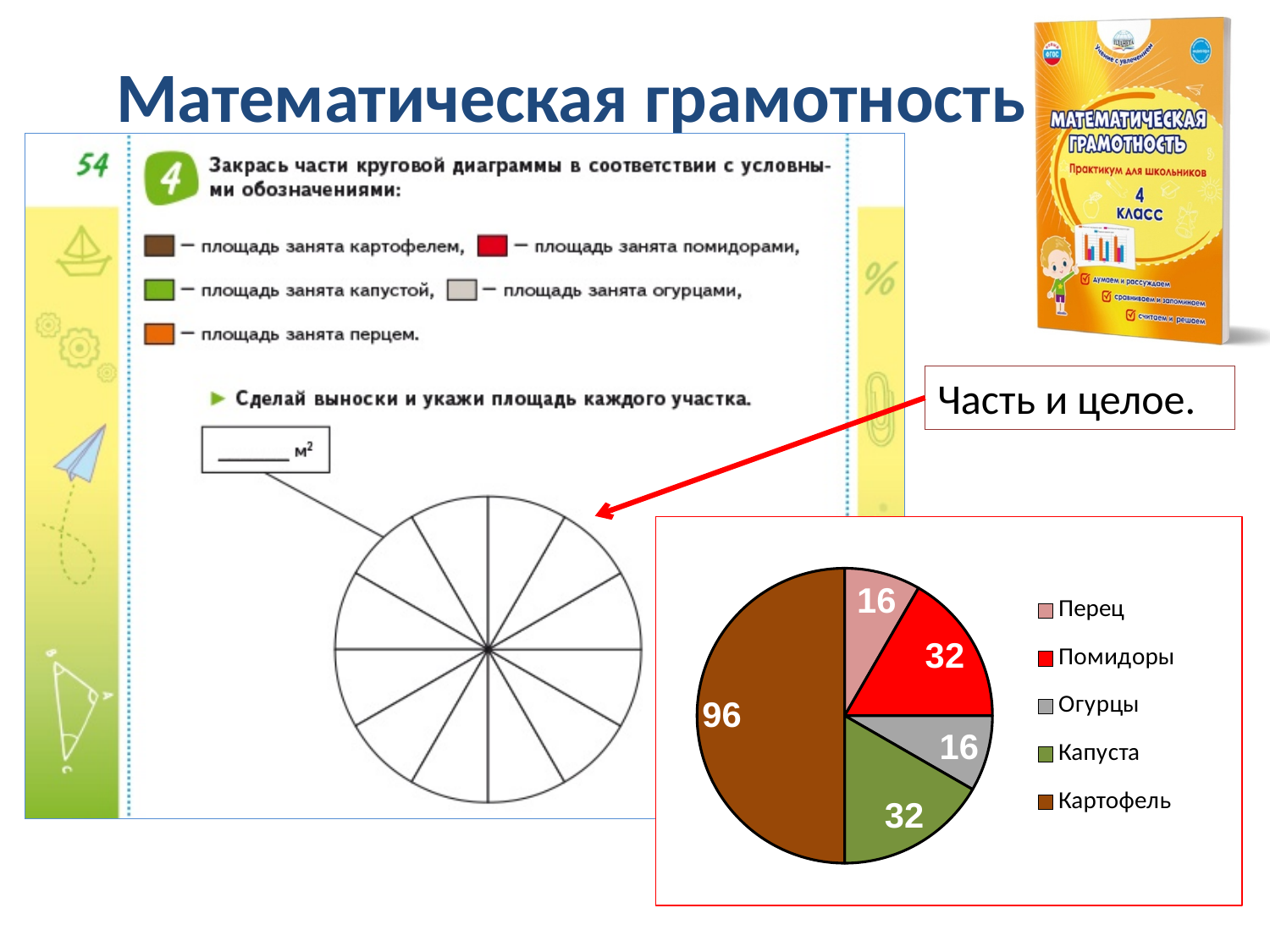
In the pie chart, which is larger: the value for Помидоры or the value for Огурцы? Помидоры In the pie chart, what is the difference between the values for Картофель and Капуста? 64 In the pie chart, what is the value for Огурцы? 16 How many entries does the legend of the pie chart list? 5 In the pie chart, what is the value for Перец? 16 What type of chart is shown in the red-bordered box on the right of the slide? pie chart What share of the whole pie does the Картофель slice represent? 50% Which category has the largest slice in the pie chart? Картофель What colour is the Картофель slice in the pie chart? brown In the pie chart, what is the value for Картофель? 96 How many slices does the pie chart have? 5 In the pie chart, what is the value for Помидоры? 32